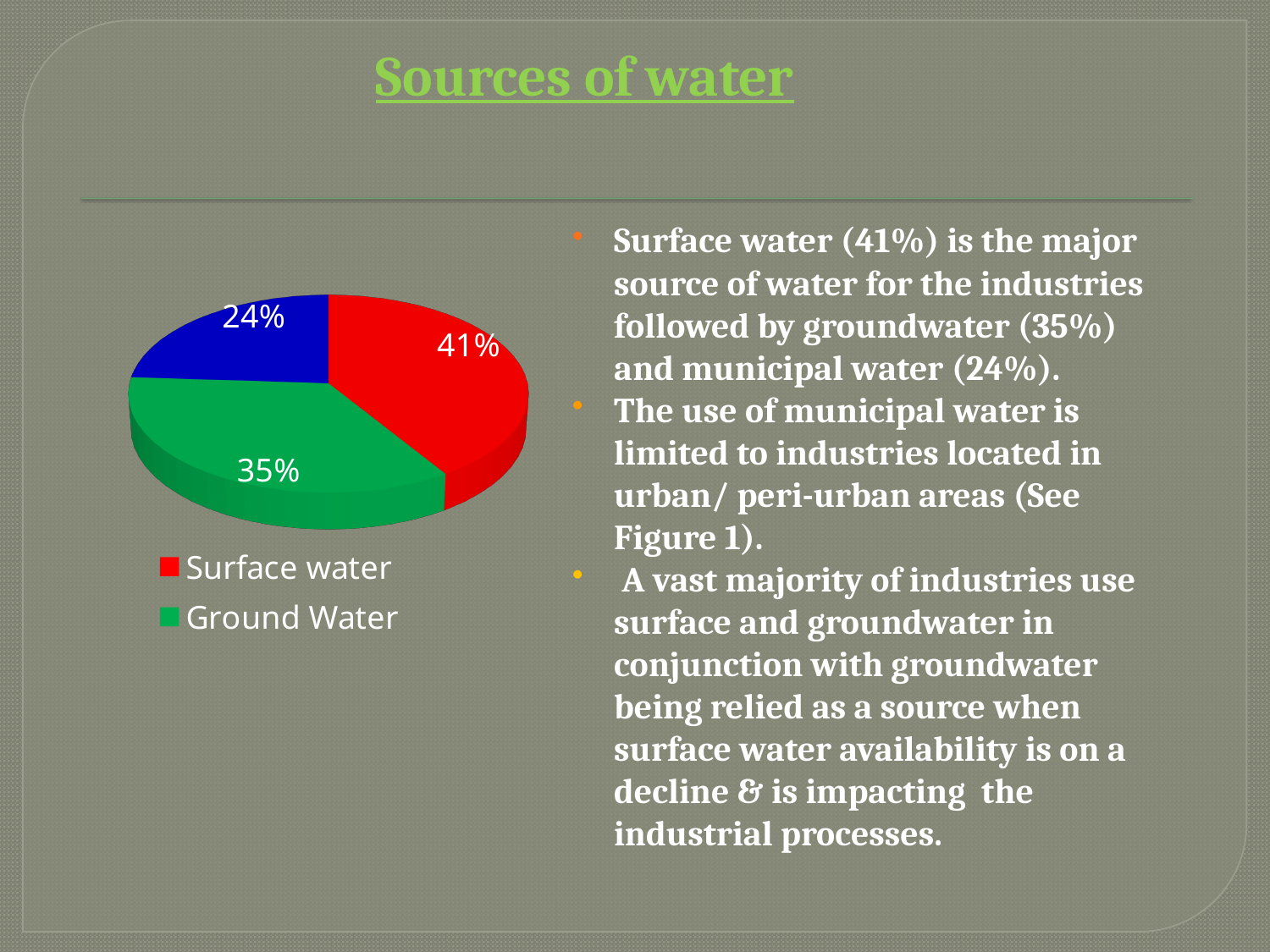
What colour represents Surface water in the pie chart? Red What percentage of the pie chart is Ground Water? 35% What kind of chart is shown on the slide? Pie chart How many entries does the chart legend list? 2 What percentage of the pie chart is Surface water? 41% What is the difference between the Surface water slice and the blue 24% slice? 17% How many slices does the pie chart have? 3 What percentage is shown on the blue slice of the pie chart? 24% What percentage does the smallest slice of the pie chart show? 24% How many percentage points larger is the Surface water slice than the Ground Water slice? 6% Which source has the largest slice in the pie chart? Surface water Which is larger, the Ground Water slice or the blue slice? Ground Water